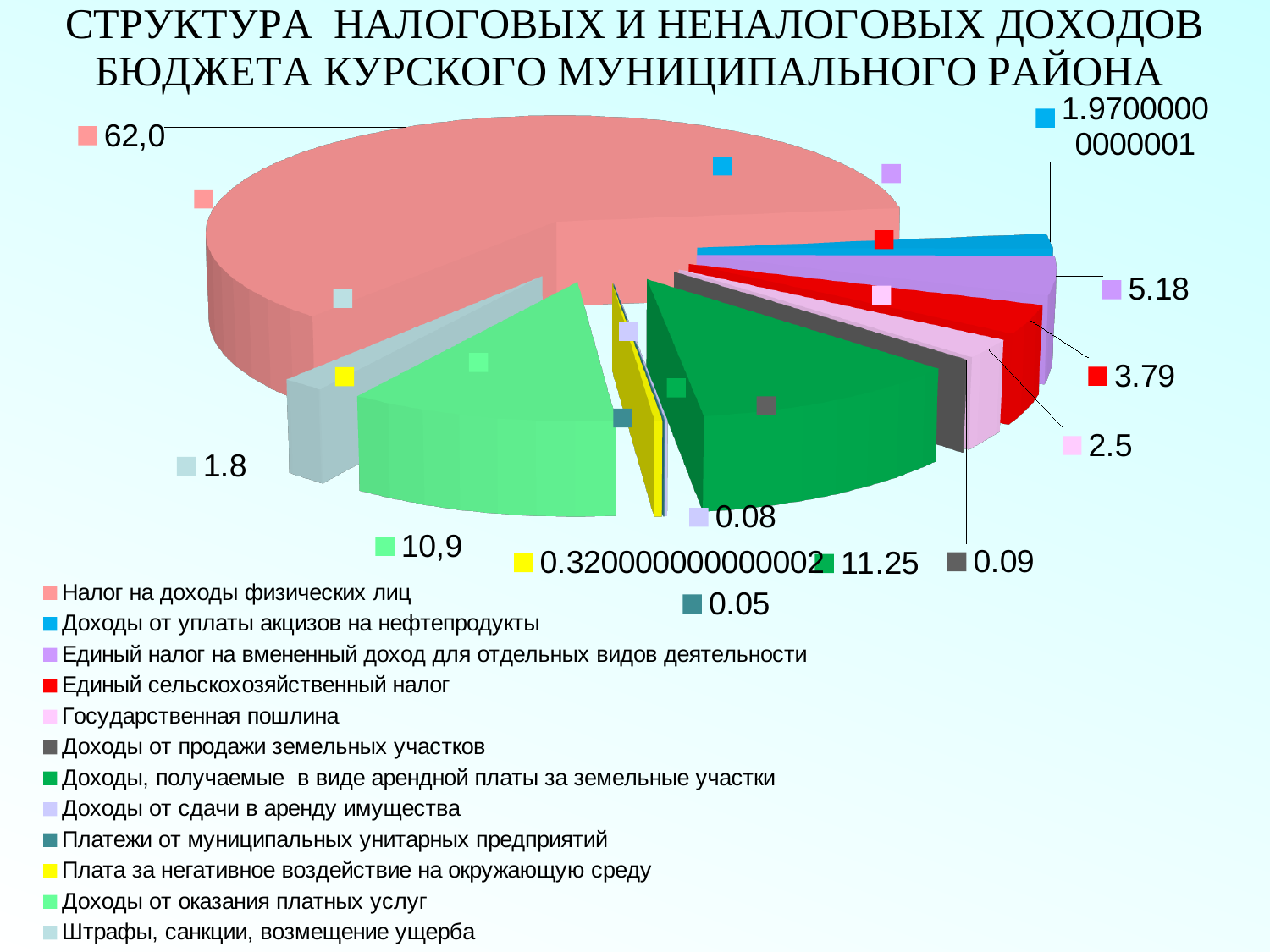
Which is larger: Доходы, получаемые в виде арендной платы за земельные участки or Доходы от оказания платных услуг? Доходы, получаемые в виде арендной платы за земельные участки What colour is the slice for Единый сельскохозяйственный налог? Red What is the value shown for Налог на доходы физических лиц? 62,0 What is the value shown for Государственная пошлина? 2.5 What is the value shown for Доходы, получаемые в виде арендной платы за земельные участки? 11.25 Which category has the largest share of the pie? Налог на доходы физических лиц What is the value shown for Единый налог на вмененный доход для отдельных видов деятельности? 5.18 What is the difference between the values for Налог на доходы физических лиц and Доходы от оказания платных услуг? 51,1 Which category has the smallest value in the chart? Платежи от муниципальных унитарных предприятий What type of chart is shown on the slide? Pie chart What is the value shown for Штрафы, санкции, возмещение ущерба? 1.8 How many categories does the legend list? 12